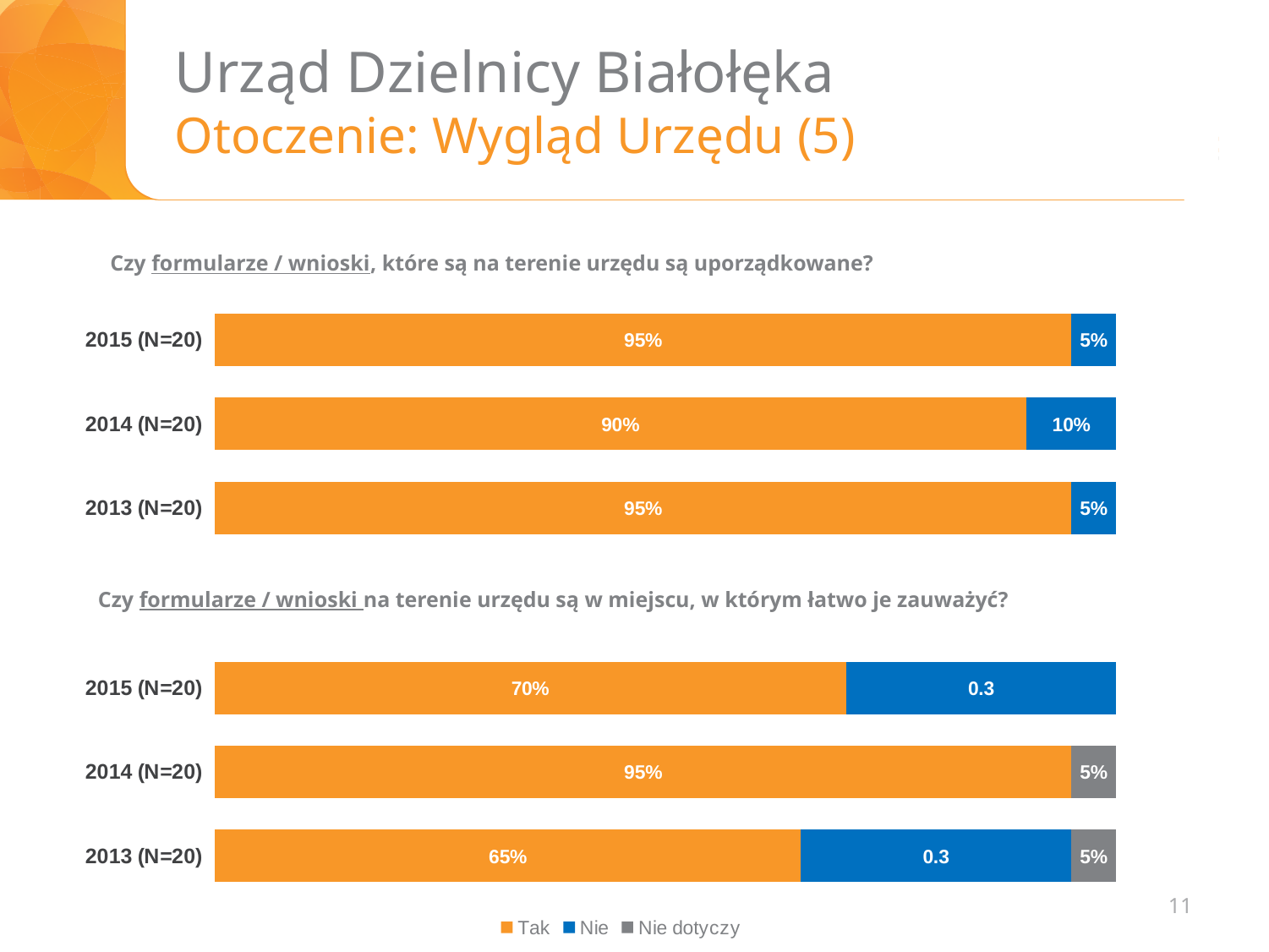
In the top chart, what is the 'Nie' value for 2014 (N=20)? 10% In the bottom chart, what is the 'Tak' value for 2013 (N=20)? 65% In the top chart, what is the 'Tak' value for 2014 (N=20)? 90% In the bottom chart, is the 'Tak' value for 2015 (N=20) larger or smaller than the 'Tak' value for 2013 (N=20)? larger In the bottom chart, which year has the highest 'Tak' value? 2014 (N=20) In the bottom chart, what is the 'Nie dotyczy' value for 2014 (N=20)? 5% In the top chart, what is the difference between the 'Nie' values for 2014 (N=20) and 2015 (N=20)? 5% In the top chart, what is the 'Tak' value for 2015 (N=20)? 95% How many series does the legend list? 3 What type of chart is used on this slide? bar chart In the bottom chart, what is the 'Nie' value for 2015 (N=20)? 0.3 In the top chart, which year has the lowest 'Tak' value? 2014 (N=20)